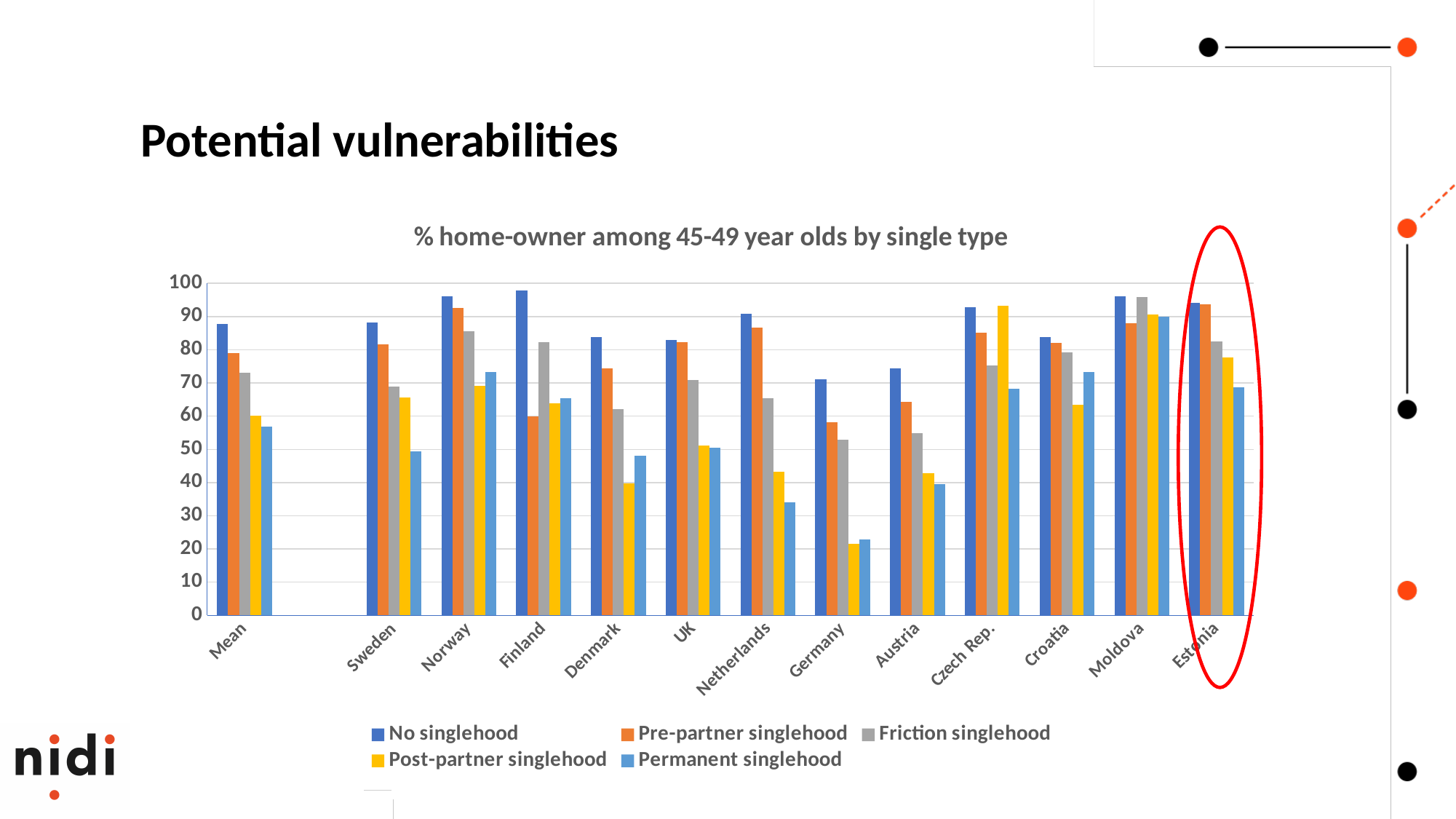
Is the value for Post-partner singlehood in Germany greater or less than 30? less Is the value for No singlehood in Finland greater or less than 90? greater Which country has the lowest value for Permanent singlehood? Germany In Finland, which is larger: Pre-partner singlehood or Friction singlehood? Friction singlehood How many series does the legend list? 5 Is the value for Permanent singlehood in the Netherlands greater or less than 40? less In the Netherlands, which is larger: Post-partner singlehood or Permanent singlehood? Post-partner singlehood What is the title of the chart? % home-owner among 45-49 year olds by single type What kind of chart is shown on the slide? bar chart How many categories are shown on the x axis? 13 Which country on the x axis is circled in red? Estonia